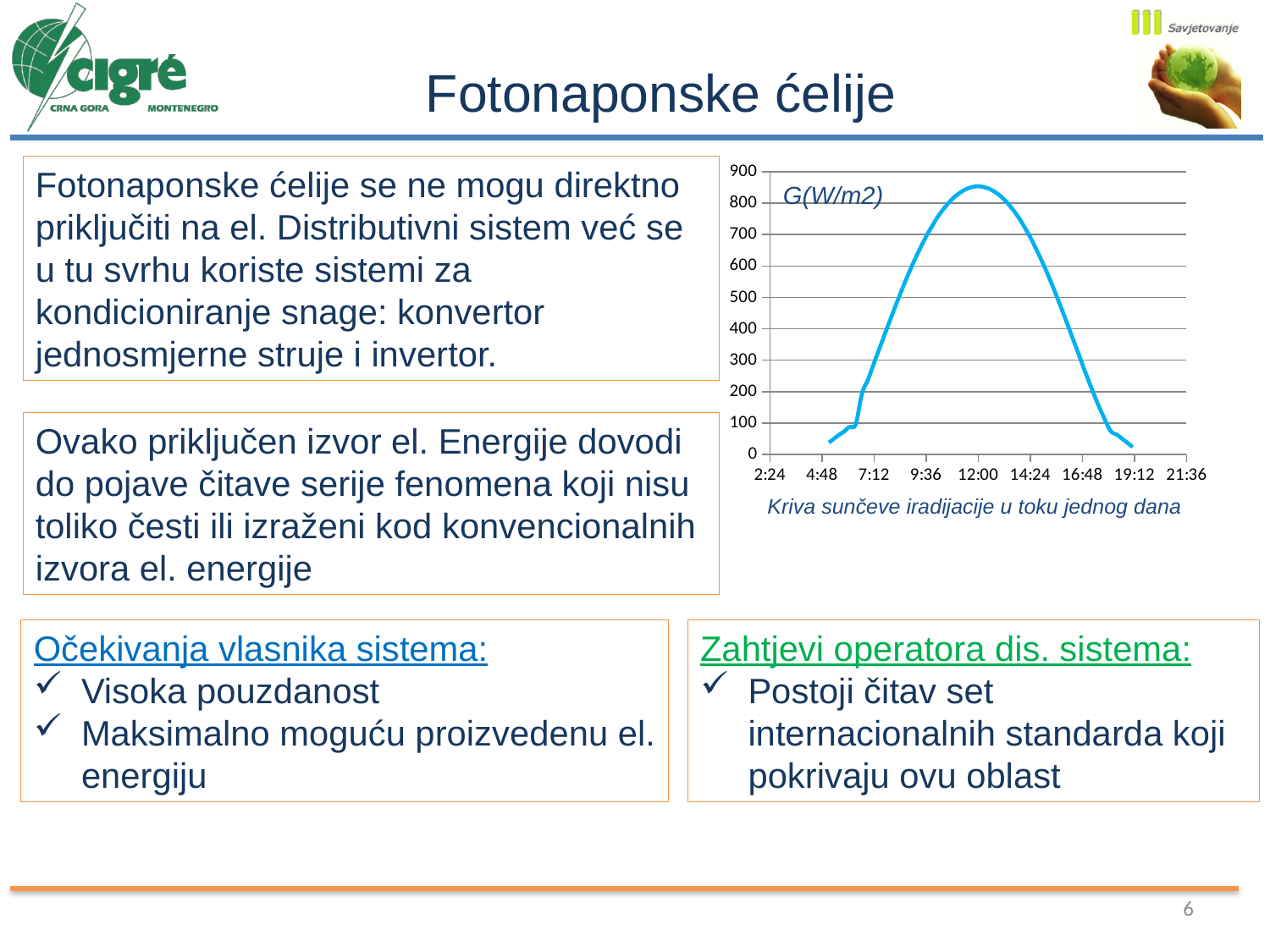
What is the caption written below the chart? Kriva sunčeve iradijacije u toku jednog dana Is the value of the curve at 14:24 greater or less than 500? greater Is the value of the curve at 19:12 greater or less than 100? less What is the highest tick value shown on the y axis? 900 Is the value of the curve at 16:48 greater or less than 400? less At which x-axis time does the curve reach its highest value? 12:00 How does the curve behave from 12:00 to 19:12 along the x axis? falls What kind of chart is shown on the slide? line chart How does the curve behave from 4:48 to 12:00 along the x axis? rises What label is written inside the chart near the top of the y axis? G(W/m2)